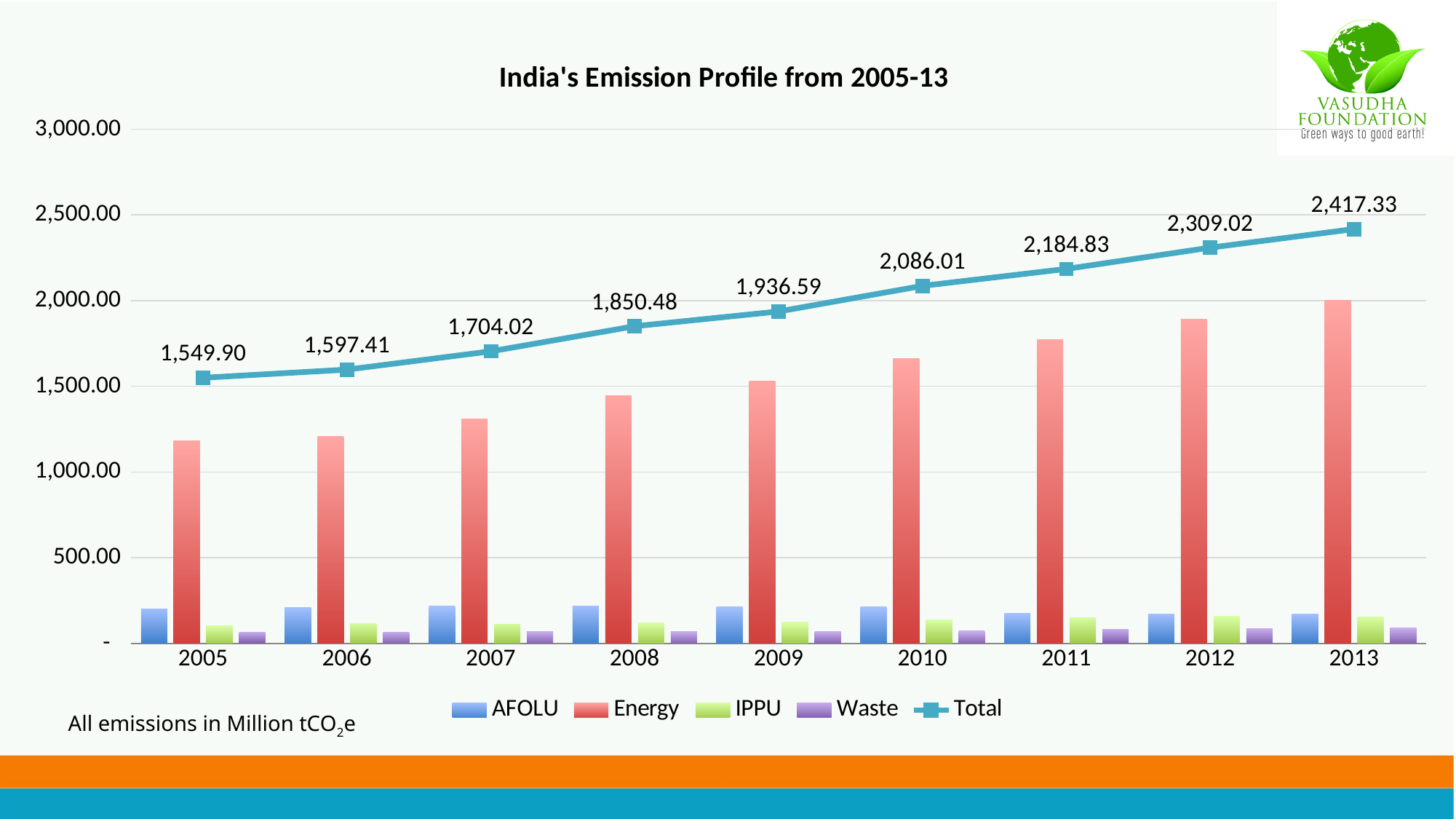
Which is larger, the Total emissions in 2008 or in 2010? 2010 Is the value for Energy in 2012 greater or less than 2,000? less Which year has the highest Total emissions? 2013 How many series does the legend list? 5 What is the difference between the Total emissions in 2012 and 2011? 124.19 How many years are shown on the x axis? 9 What is the Total emissions value for 2009? 1,936.59 Is the value for Energy in 2005 greater or less than 1,000? greater What is the Total emissions value for 2005? 1,549.90 What is the Total emissions value for 2013? 2,417.33 What is the difference between the Total emissions in 2013 and 2005? 867.43 Which year has the lowest Total emissions? 2005